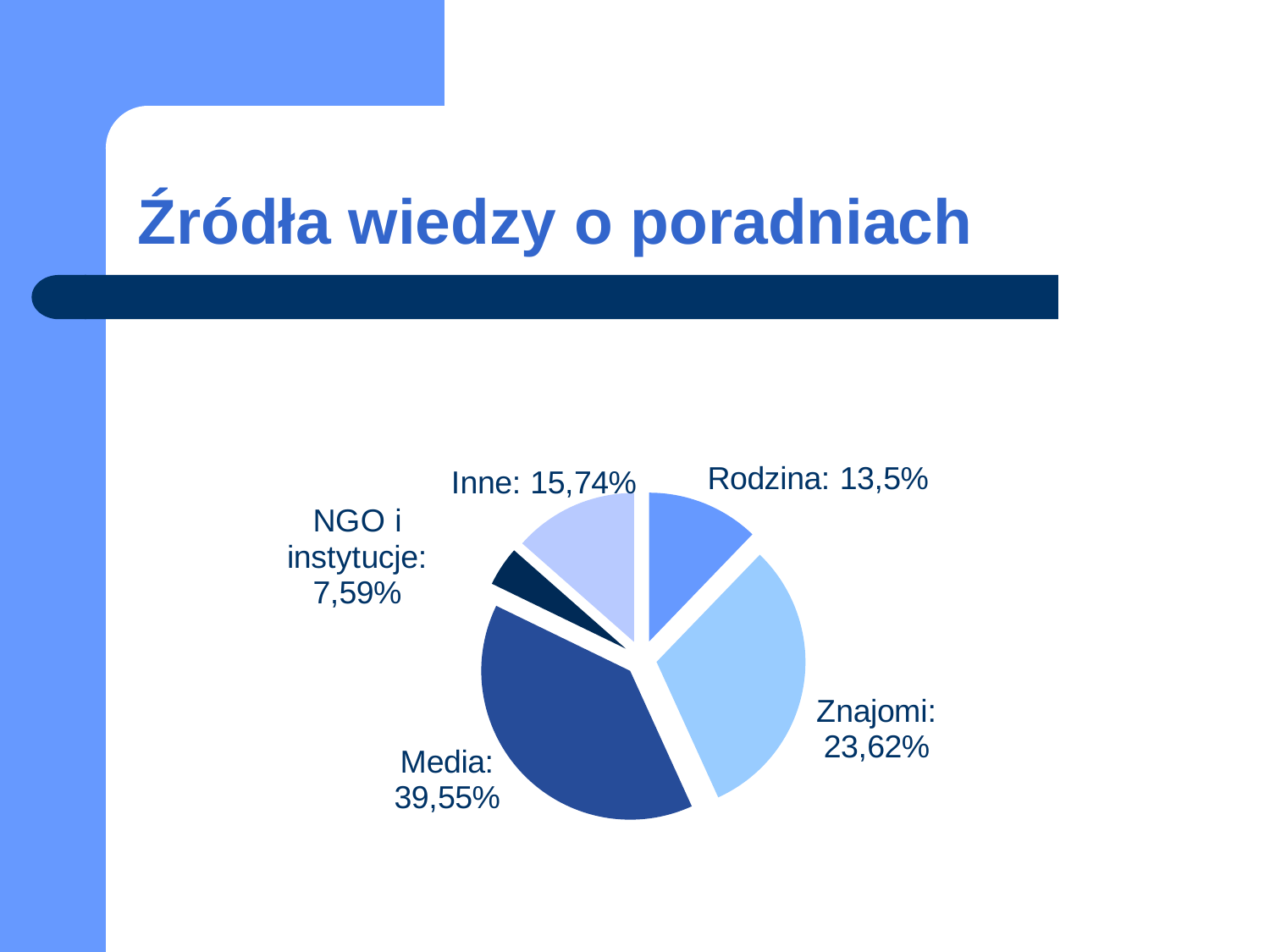
Which is larger, the share for Znajomi or the share for Inne? Znajomi What kind of chart is shown on the slide? pie chart What is the share for Inne? 15,74% What is the share for Rodzina? 13,5% What is the difference between the shares for Media and Znajomi? 15,93% How many slices does the pie chart have? 5 What is the share for Media? 39,55% What is the share for NGO i instytucje? 7,59% What is the share for Znajomi? 23,62% Which category has the smallest slice of the pie? NGO i instytucje What is the title of the slide containing the chart? Źródła wiedzy o poradniach Which category has the largest slice of the pie? Media